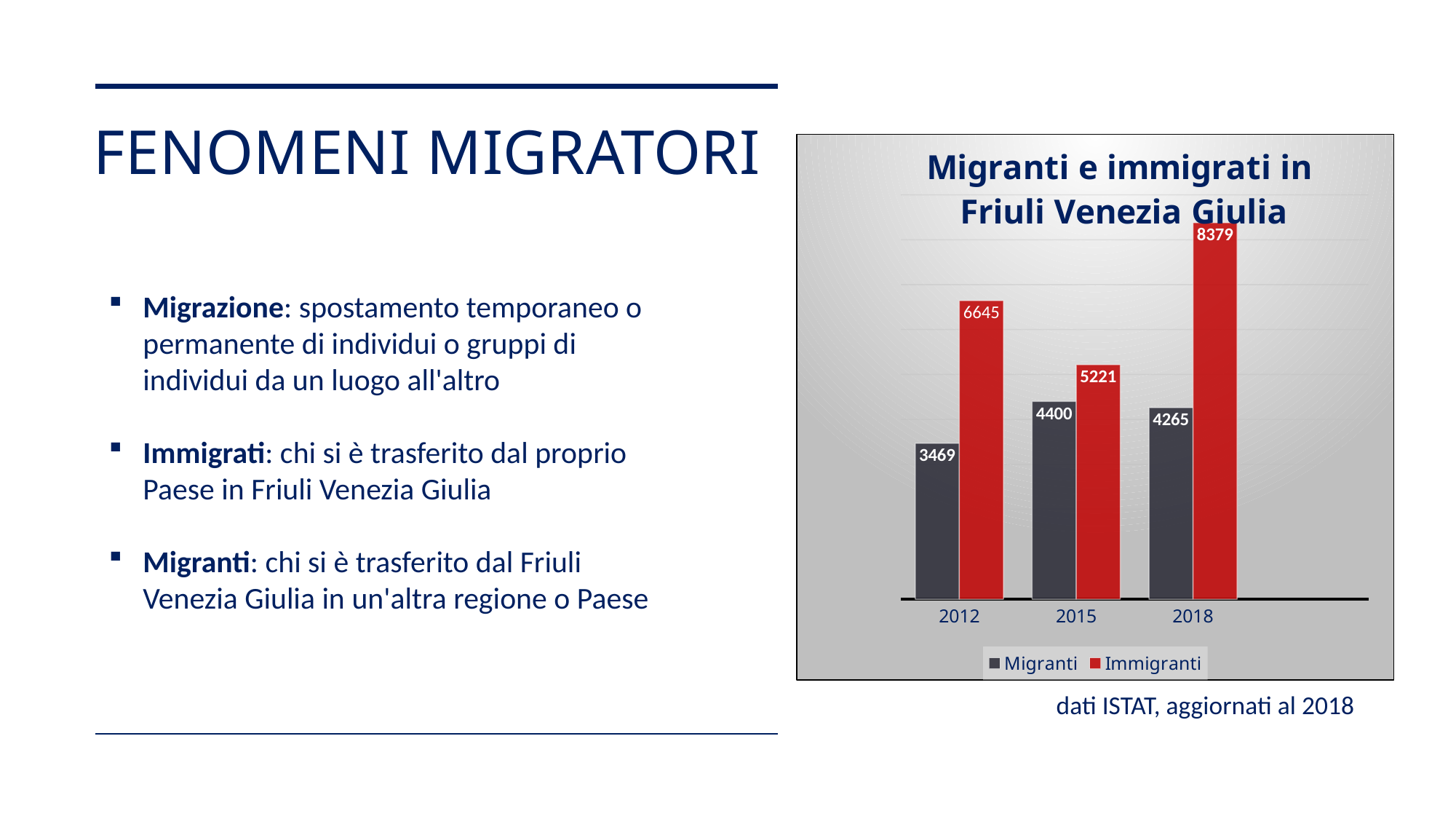
What is the difference between Immigranti in 2012 and Immigranti in 2015? 1424 How many series does the legend list? 2 In which year is the Immigranti value highest? 2018 What is the difference between Immigranti and Migranti in 2018? 4114 What is the value for Immigranti in 2015? 5221 What is the value for Immigranti in 2018? 8379 Which is larger in 2015, Migranti or Immigranti? Immigranti What is the value for Migranti in 2018? 4265 What type of chart is shown on the slide? Bar chart In which year is the Migranti value highest? 2015 What is the value for Migranti in 2012? 3469 In which year is the Immigranti value lowest? 2015